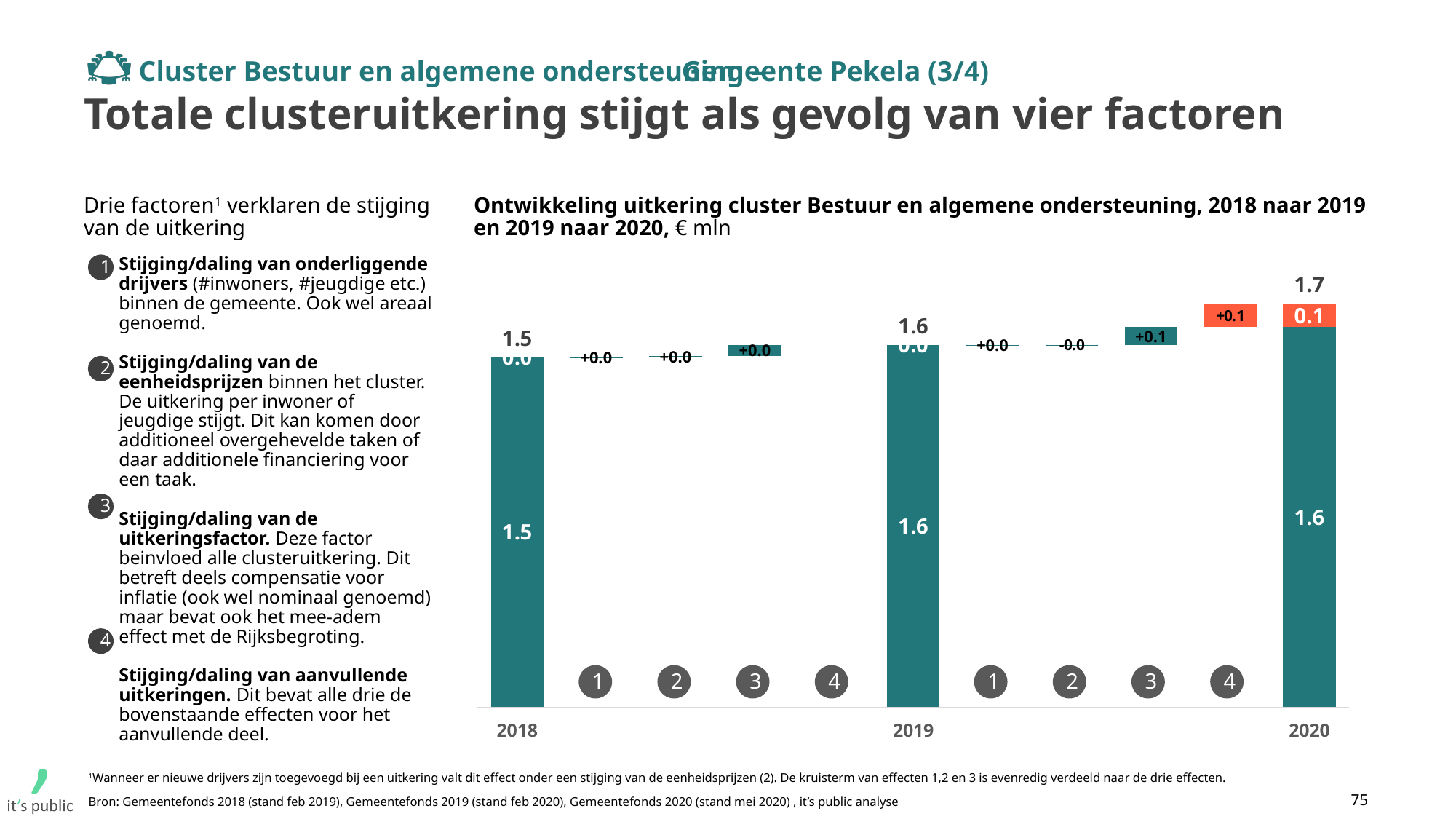
Which year has the highest total uitkering? 2020 Do the total uitkering values rise or fall from 2018 to 2020? rise Is the total for 2020 larger or smaller than the total for 2019? larger In what unit are the values in the chart expressed? € mln What is the total uitkering shown for 2019? 1.6 Which year has the lowest total uitkering? 2018 What is the total uitkering shown for 2020? 1.7 What is the total uitkering shown for 2018? 1.5 How many years are shown with a total bar in the chart? 3 What is the difference between the total for 2020 and the total for 2018? 0.2 What is the value of the effect of factor 3 (uitkeringsfactor) from 2019 to 2020? +0.1 What is the value of the effect of factor 4 (aanvullende uitkeringen) from 2019 to 2020? +0.1